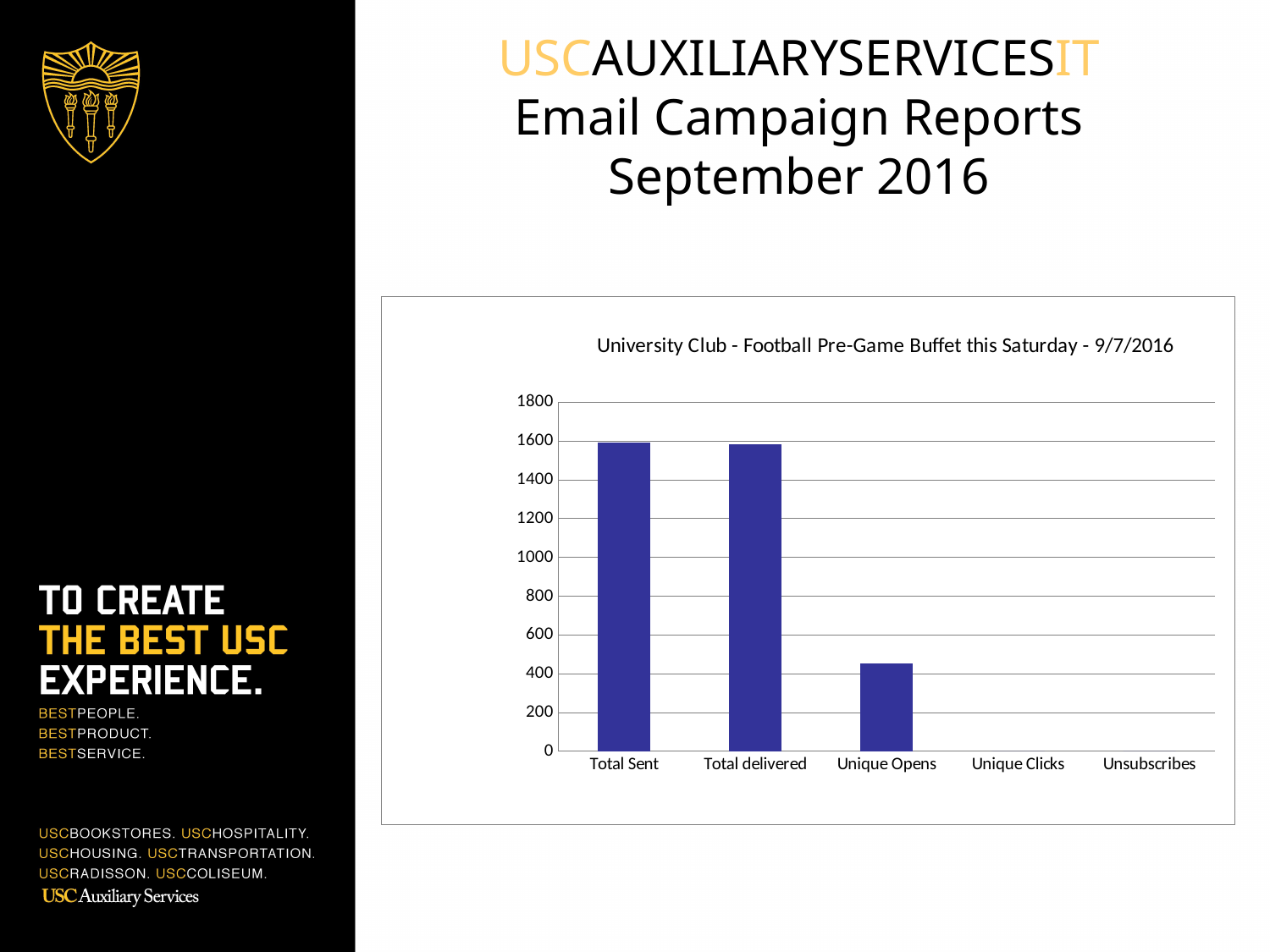
Is the value for Total Sent greater or less than 1400? greater Is the value for Unique Opens greater or less than 200? greater Which is larger, the value for Total Sent or the value for Unique Opens? Total Sent How many categories are shown on the x axis of the chart? 5 Is the value for Total delivered greater or less than 1200? greater What is the label of the third category on the x axis? Unique Opens Do the values generally rise or fall moving from left to right along the x axis? fall What kind of chart is shown on the slide? bar chart What is the title of the chart? University Club - Football Pre-Game Buffet this Saturday - 9/7/2016 Which is larger, the value for Unique Opens or the value for Unsubscribes? Unique Opens